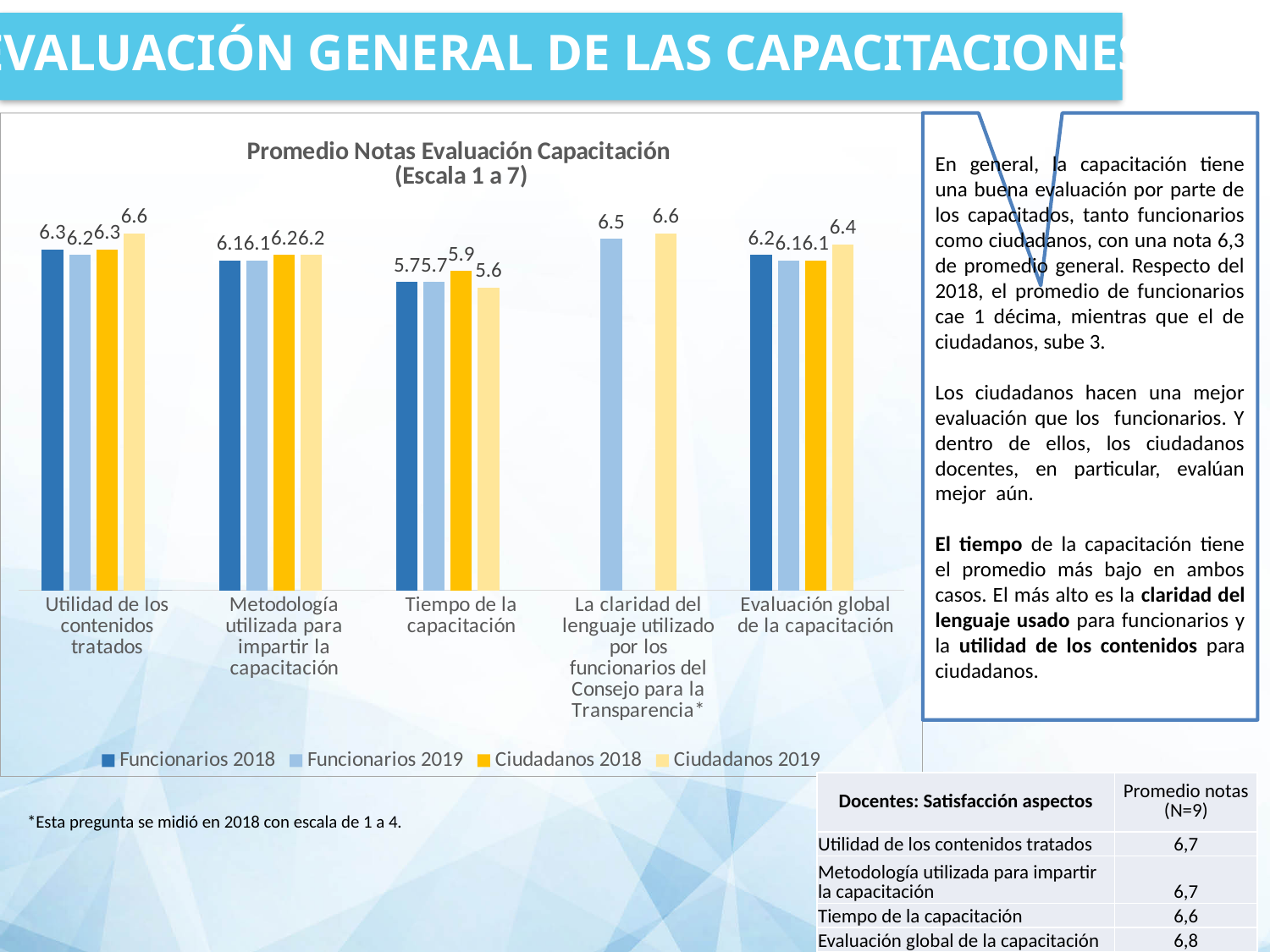
How many series does the chart legend list? 4 What is the value for Funcionarios 2018 in the category 'Tiempo de la capacitación'? 5.7 What is the value for Funcionarios 2019 in the category 'La claridad del lenguaje utilizado por los funcionarios del Consejo para la Transparencia*'? 6.5 In the category 'Tiempo de la capacitación', which is larger: the value for Ciudadanos 2018 or Ciudadanos 2019? Ciudadanos 2018 What kind of chart is shown on the slide? bar chart Which category has the lowest value for Ciudadanos 2019? Tiempo de la capacitación What is the value for Ciudadanos 2019 in the category 'Utilidad de los contenidos tratados'? 6.6 What is the title of the chart? Promedio Notas Evaluación Capacitación (Escala 1 a 7) What is the difference between the Ciudadanos 2019 and Funcionarios 2019 values in the category 'Evaluación global de la capacitación'? 0.3 What is the difference between the Ciudadanos 2019 and Funcionarios 2019 values in the category 'Utilidad de los contenidos tratados'? 0.4 What is the value for Ciudadanos 2019 in the category 'Evaluación global de la capacitación'? 6.4 How many categories are shown on the x axis of the chart? 5